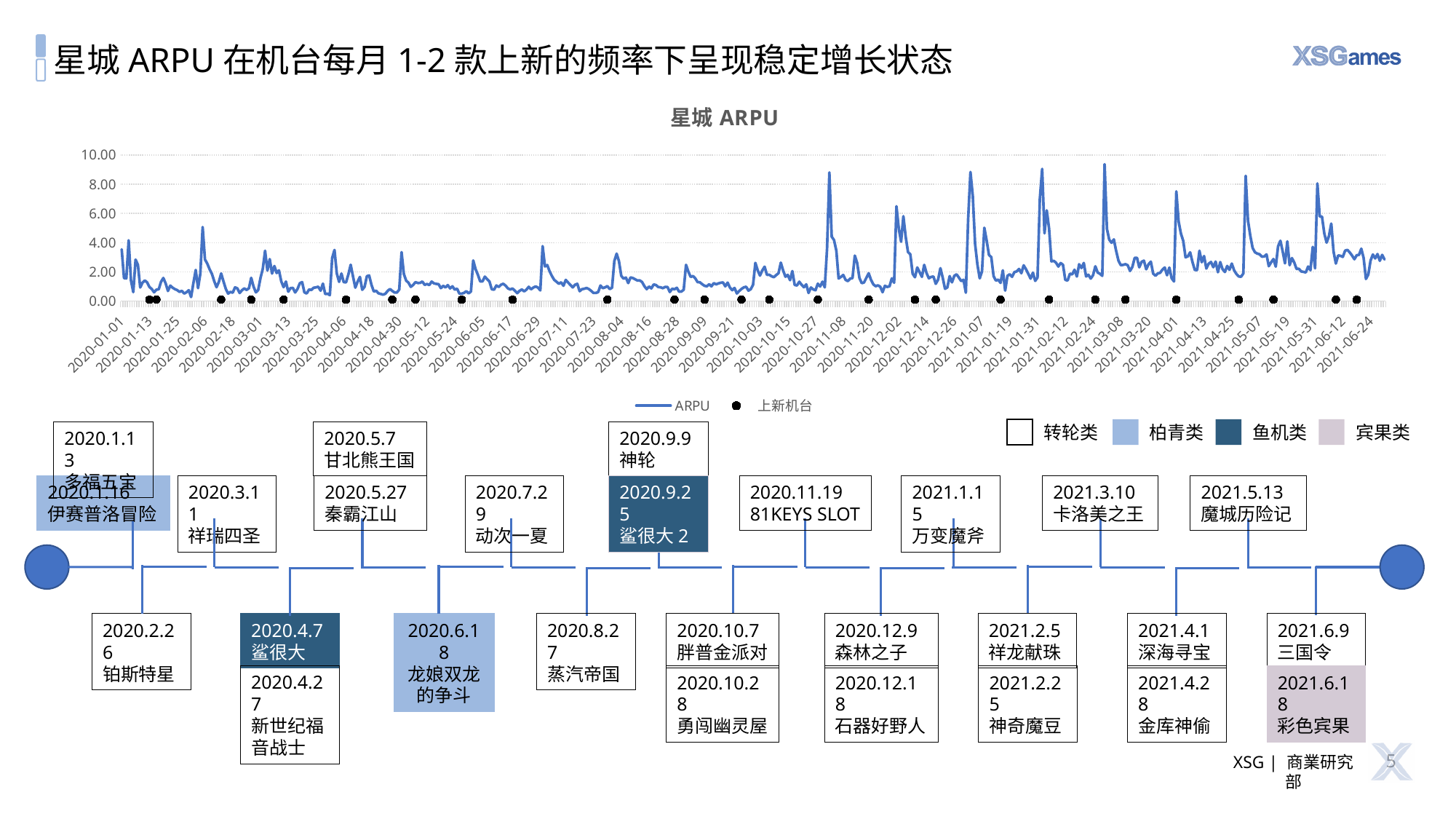
What kind of chart is shown on the slide? line chart Is the ARPU peak near 2020-02-06 greater or less than 6.00? less Overall, does the ARPU line rise or fall from the start of 2020 to mid-2021? rise Which is larger: the ARPU peak near 2021-03-08 or the ARPU peak near 2020-02-06? the peak near 2021-03-08 What does the black dot series in the legend represent? 上新机台 What is the highest value shown on the y axis? 10.00 Is the ARPU peak near 2021-03-08 greater or less than 8.00? greater Is the ARPU value at 2020-01-01 greater or less than 4.00? less What is the first date label shown on the x axis? 2020-01-01 What is the title of the chart? 星城 ARPU How many series does the chart legend list? 2